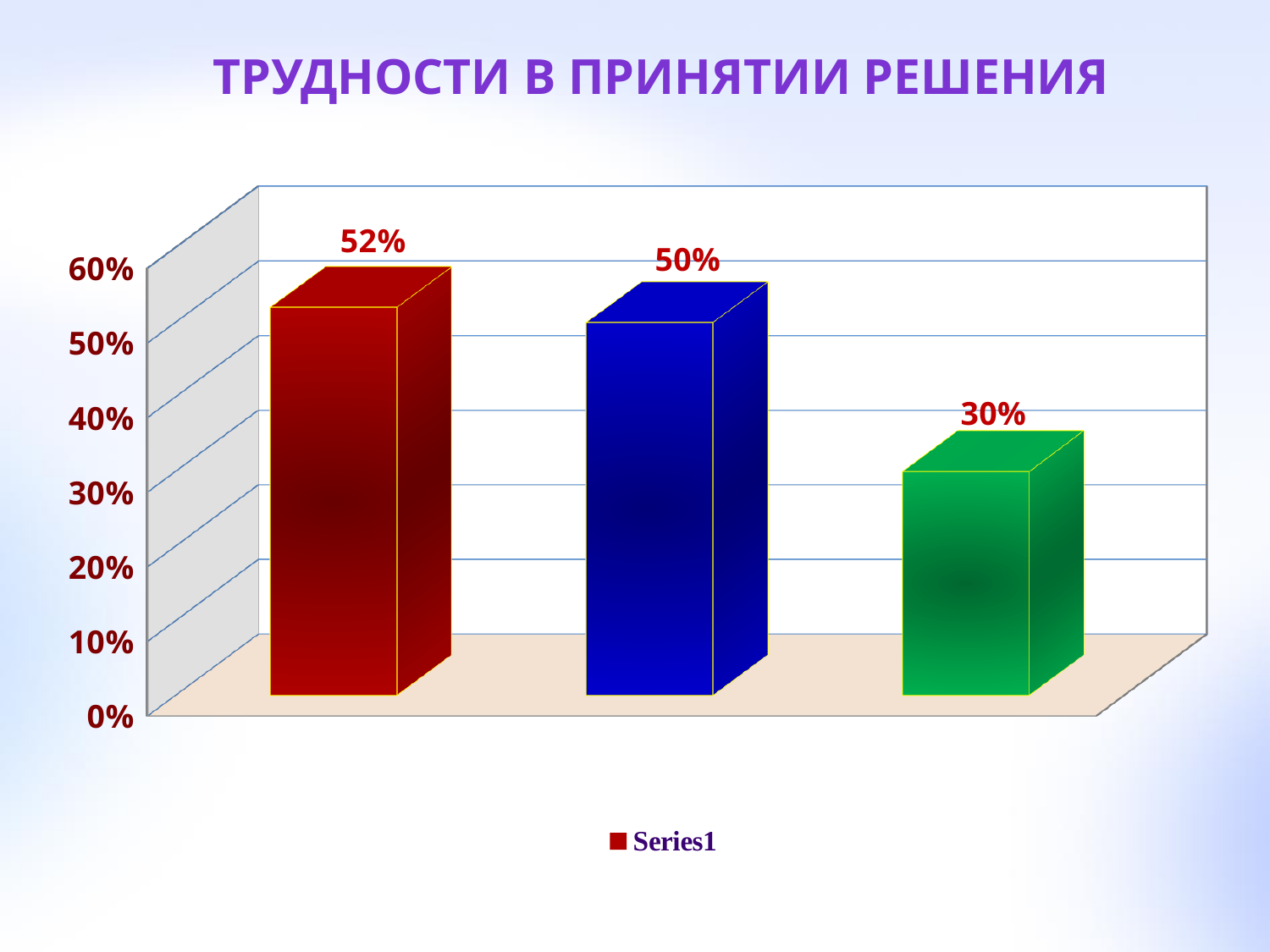
What is the value shown on the green (third) bar? 30% Which bar has the lowest value? The green (third) bar, 30% How many series does the legend list? 1 What is the difference between the red bar and the blue bar? 2% How many bars are plotted in the chart? 3 What is the difference between the red bar and the green bar? 22% What is the value shown on the red (first) bar? 52% What kind of chart is shown on the slide? Bar chart Which bar has the highest value? The red (first) bar, 52% What is the value shown on the blue (second) bar? 50% What is the title of the chart? ТРУДНОСТИ В ПРИНЯТИИ РЕШЕНИЯ Which is larger, the blue bar or the green bar? The blue bar